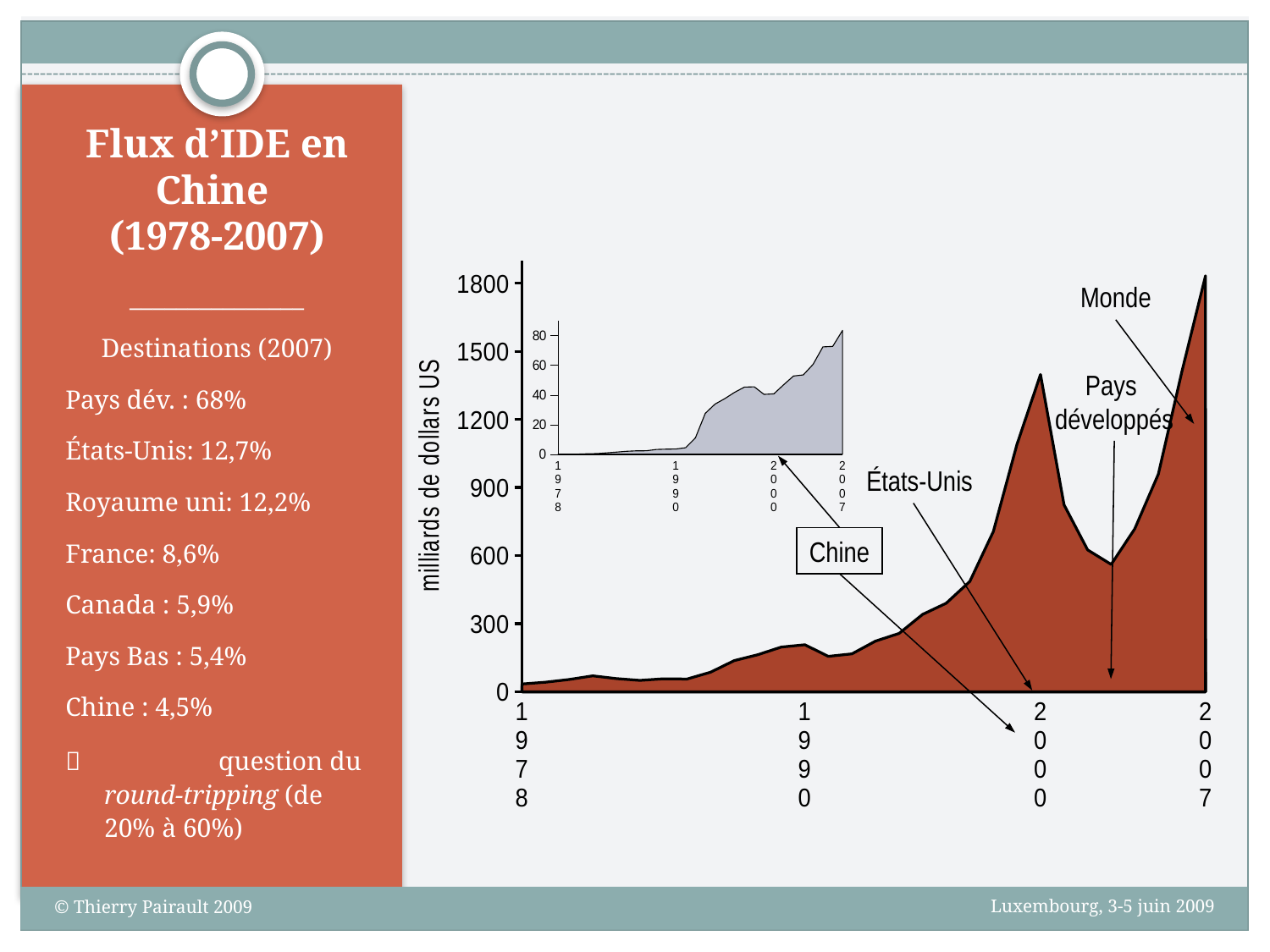
On the main chart, is the value for Monde in 1990 greater or less than 300? less What is the first year shown on the x axis of the main chart? 1978 On the main chart, is the value for Monde in 1978 greater or less than 300? less On the main chart, is the value for Monde in 2000 greater or less than 1200? greater On the main chart, do the values for Monde generally rise or fall from 1978 to 2007? rise What is the label of the vertical axis of the main chart? milliards de dollars US What kind of chart is the main chart on the slide? area chart Which country does the small inset chart represent? Chine On the main chart, is the value for Monde in 2007 higher or lower than in 2000? higher